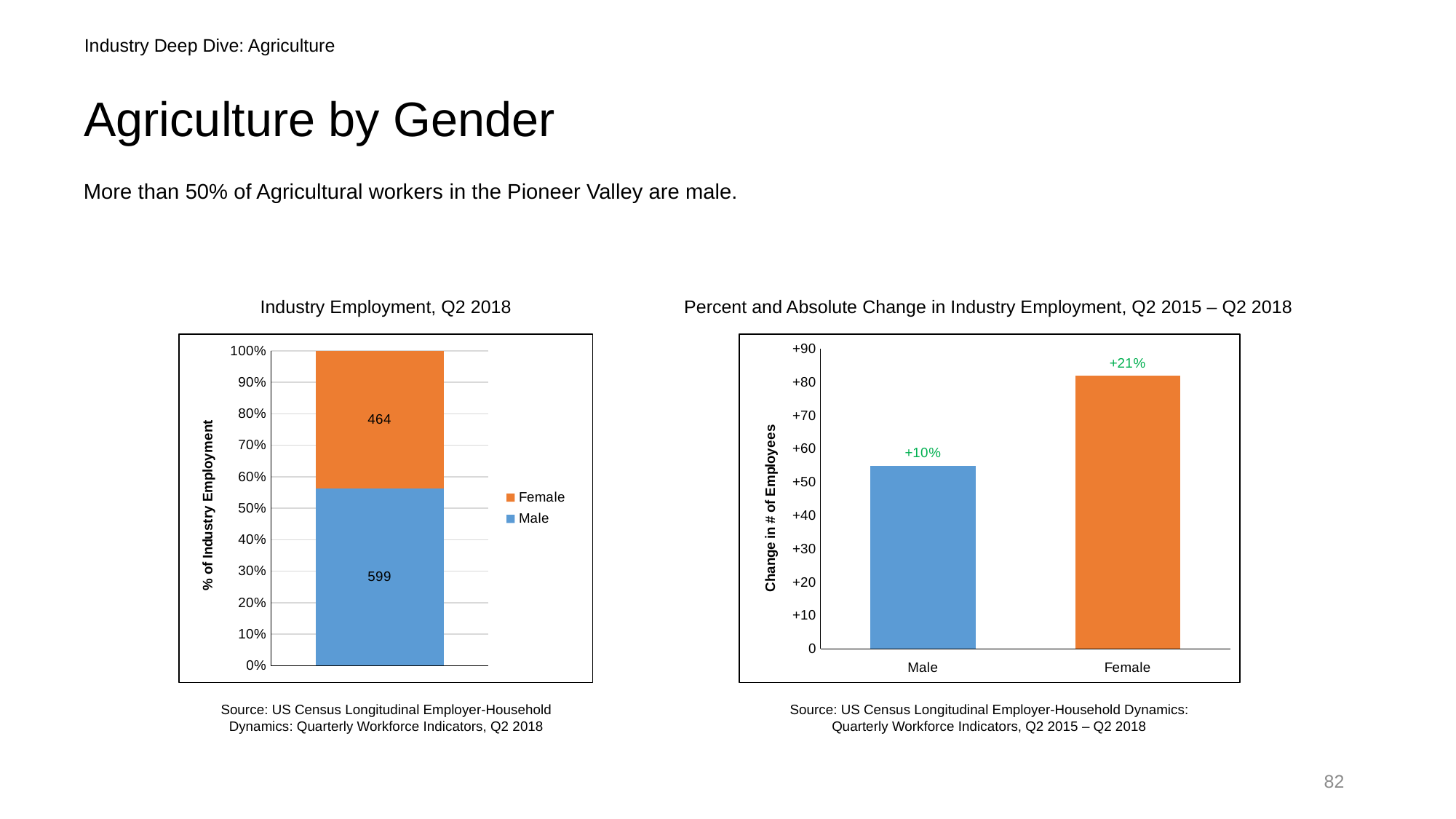
In the 'Percent and Absolute Change in Industry Employment, Q2 2015 – Q2 2018' chart, how many categories are shown on the x axis? 2 In the 'Industry Employment, Q2 2018' chart, which gender has the larger segment? Male What kind of chart is the 'Industry Employment, Q2 2018' chart? Stacked bar chart In the 'Percent and Absolute Change in Industry Employment, Q2 2015 – Q2 2018' chart, which category has the higher change in number of employees? Female In the 'Industry Employment, Q2 2018' chart, what is the value labelled on the Male segment? 599 In the 'Percent and Absolute Change in Industry Employment, Q2 2015 – Q2 2018' chart, what percent change is labelled for Male? +10% In the 'Industry Employment, Q2 2018' chart, what is the total of the stacked bar? 1063 How many series does the legend of the 'Industry Employment, Q2 2018' chart list? 2 In the 'Industry Employment, Q2 2018' chart, what is the value labelled on the Female segment? 464 In the 'Percent and Absolute Change in Industry Employment, Q2 2015 – Q2 2018' chart, is the change in number of employees for Male greater or less than +60? less In the 'Percent and Absolute Change in Industry Employment, Q2 2015 – Q2 2018' chart, what percent change is labelled for Female? +21% In the 'Industry Employment, Q2 2018' chart, what is the difference between the Male and Female values? 135